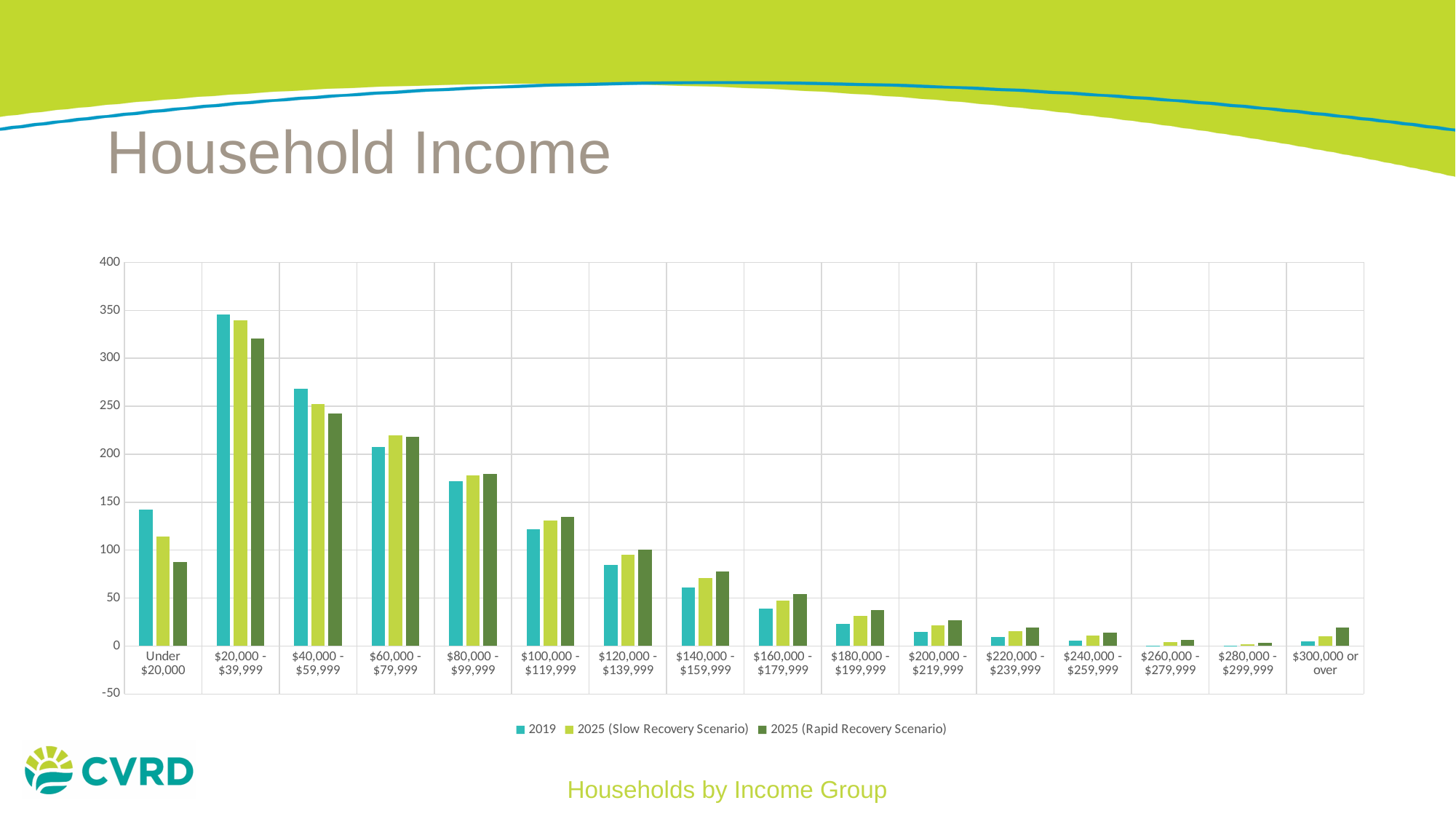
From the $20,000 - $39,999 group onward, do the 2019 values rise or fall as income increases? Fall Is the 2019 value for Under $20,000 greater or less than 100? greater Which income group has the highest 2019 value? $20,000 - $39,999 For the Under $20,000 group, which is larger: the 2019 value or the 2025 (Rapid Recovery Scenario) value? 2019 Is the 2019 value for $20,000 - $39,999 greater or less than 300? greater Is the 2025 (Rapid Recovery Scenario) value for $60,000 - $79,999 greater or less than 200? greater How many income groups are shown on the x axis? 16 What kind of chart is shown on the slide? Bar chart What is the title shown below the chart? Households by Income Group For the $100,000 - $119,999 group, which is larger: the 2019 value or the 2025 (Rapid Recovery Scenario) value? 2025 (Rapid Recovery Scenario) How many series does the legend list? 3